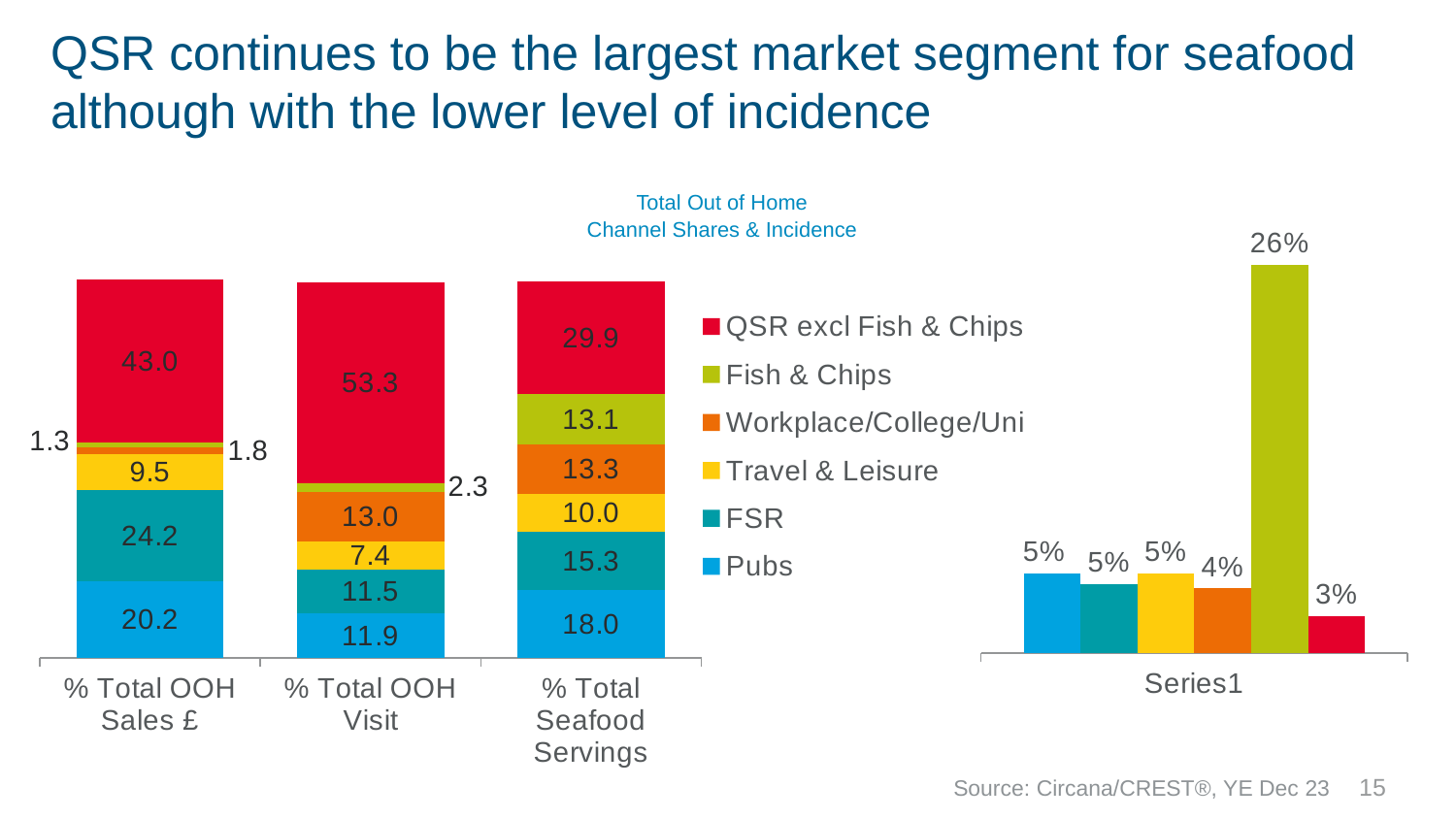
In the stacked bar chart on the left, what is the value for Workplace/College/Uni in the % Total OOH Visit bar? 13.0 In the stacked bar chart on the left, which is larger in the % Total Seafood Servings bar: Pubs or FSR? Pubs In the bar chart on the right labelled Series1, what is the value of the tallest bar? 26% How many series does the legend of the stacked bar chart list? 6 What kind of chart is the chart on the left of the slide? Stacked bar chart In the stacked bar chart on the left, which segment is the largest in the % Total OOH Sales £ bar? QSR excl Fish & Chips How many categories are shown on the x axis of the stacked bar chart on the left? 3 In the stacked bar chart on the left, what is the value for Pubs in the % Total OOH Sales £ bar? 20.2 In the stacked bar chart on the left, what is the value for FSR in the % Total Seafood Servings bar? 15.3 In the bar chart on the right labelled Series1, what is the value of the shortest bar? 3% In the stacked bar chart on the left, what is the difference between the QSR excl Fish & Chips value for % Total OOH Visit and for % Total OOH Sales £? 10.3 In the stacked bar chart 'Total Out of Home Channel Shares & Incidence', what is the value for QSR excl Fish & Chips in the % Total OOH Visit bar? 53.3